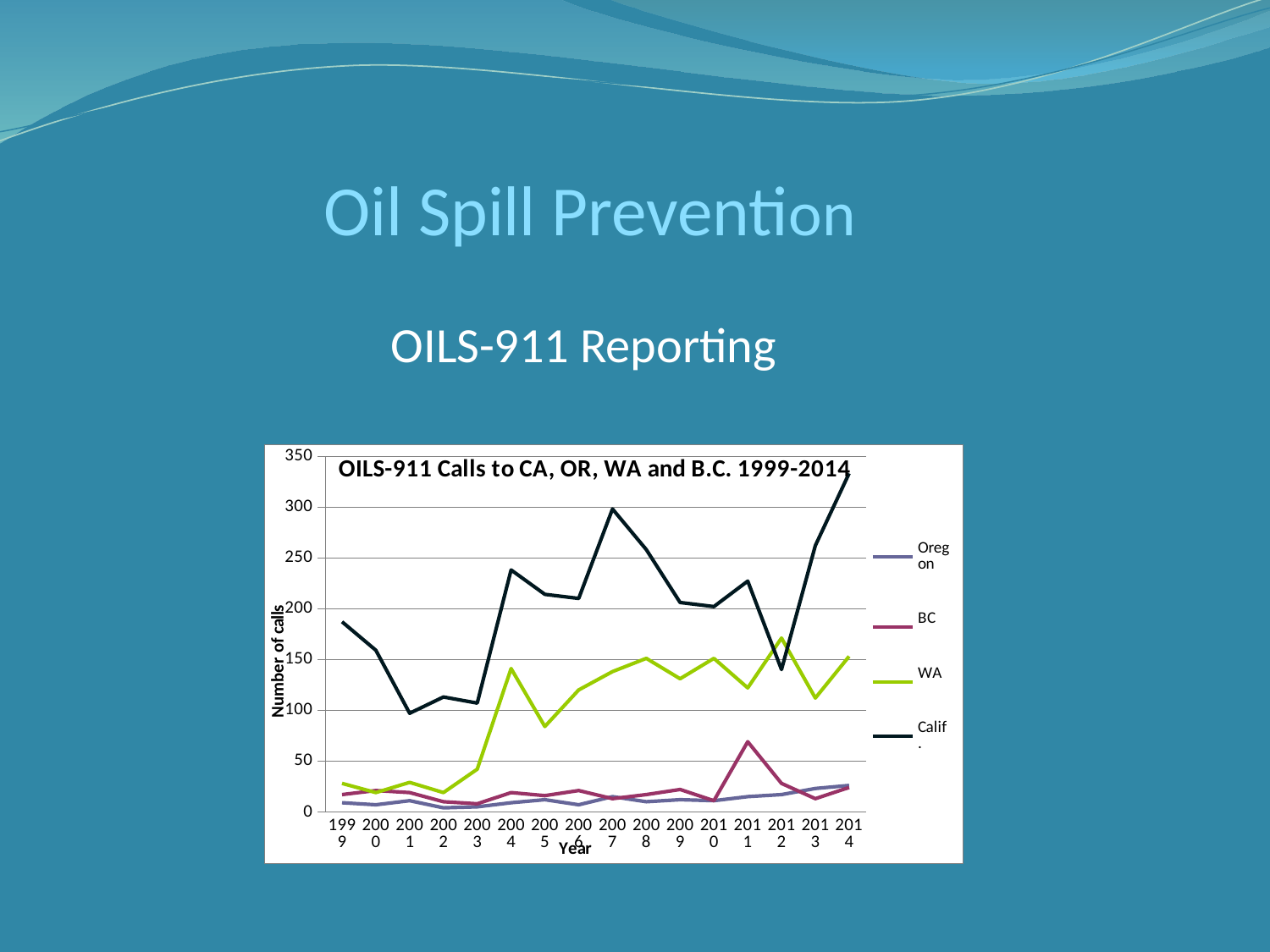
Which series has the highest value in 2014? Calif. Is the value for WA in 2005 greater or less than 100? less How many years are plotted along the x axis? 16 Is the value for Oregon in 2014 greater or less than 50? less What is the label of the vertical axis? Number of calls Does the Calif. line rise or fall from 1999 to 2001? fall Is the value for BC in 2011 greater or less than 50? greater What kind of chart is shown on the slide? line chart What is the title of the chart? OILS-911 Calls to CA, OR, WA and B.C. 1999-2014 How many series does the legend list? 4 In 2012, which series has the larger value, WA or Calif.? WA